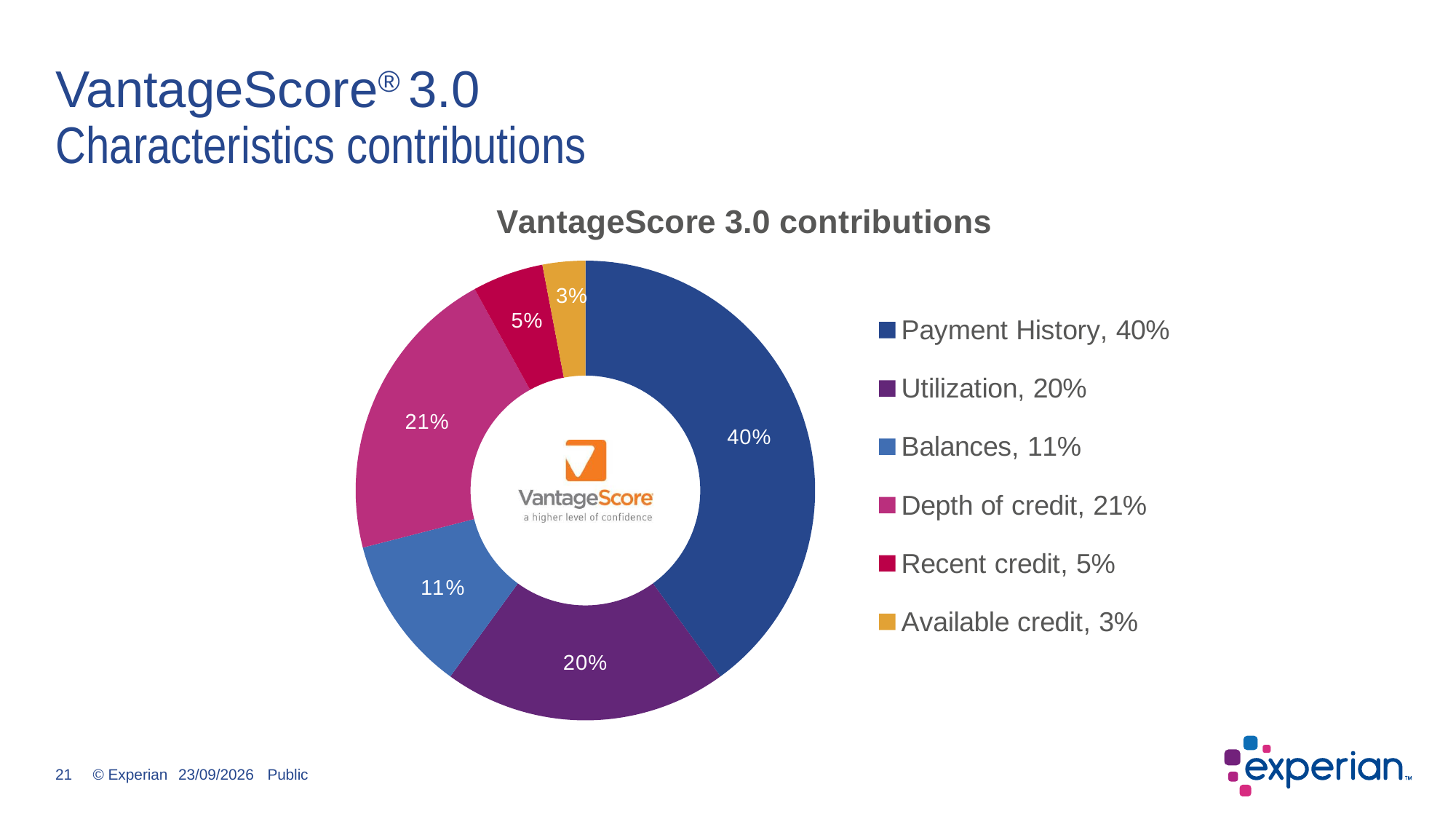
What share of the VantageScore 3.0 contributions chart is Payment History? 40% What is the title of the chart? VantageScore 3.0 contributions What is the difference between the Payment History share and the Utilization share? 20% What is the combined share of Recent credit and Available credit? 8% Which is larger, Depth of credit or Utilization? Depth of credit Which category has the largest share of the chart? Payment History What is the value shown for Balances? 11% What percentage is shown for Depth of credit? 21% How many categories are shown in the chart? 6 What percentage does Utilization contribute in the chart? 20% Which category has the smallest share of the chart? Available credit What kind of chart is shown on the slide? Pie chart (doughnut)